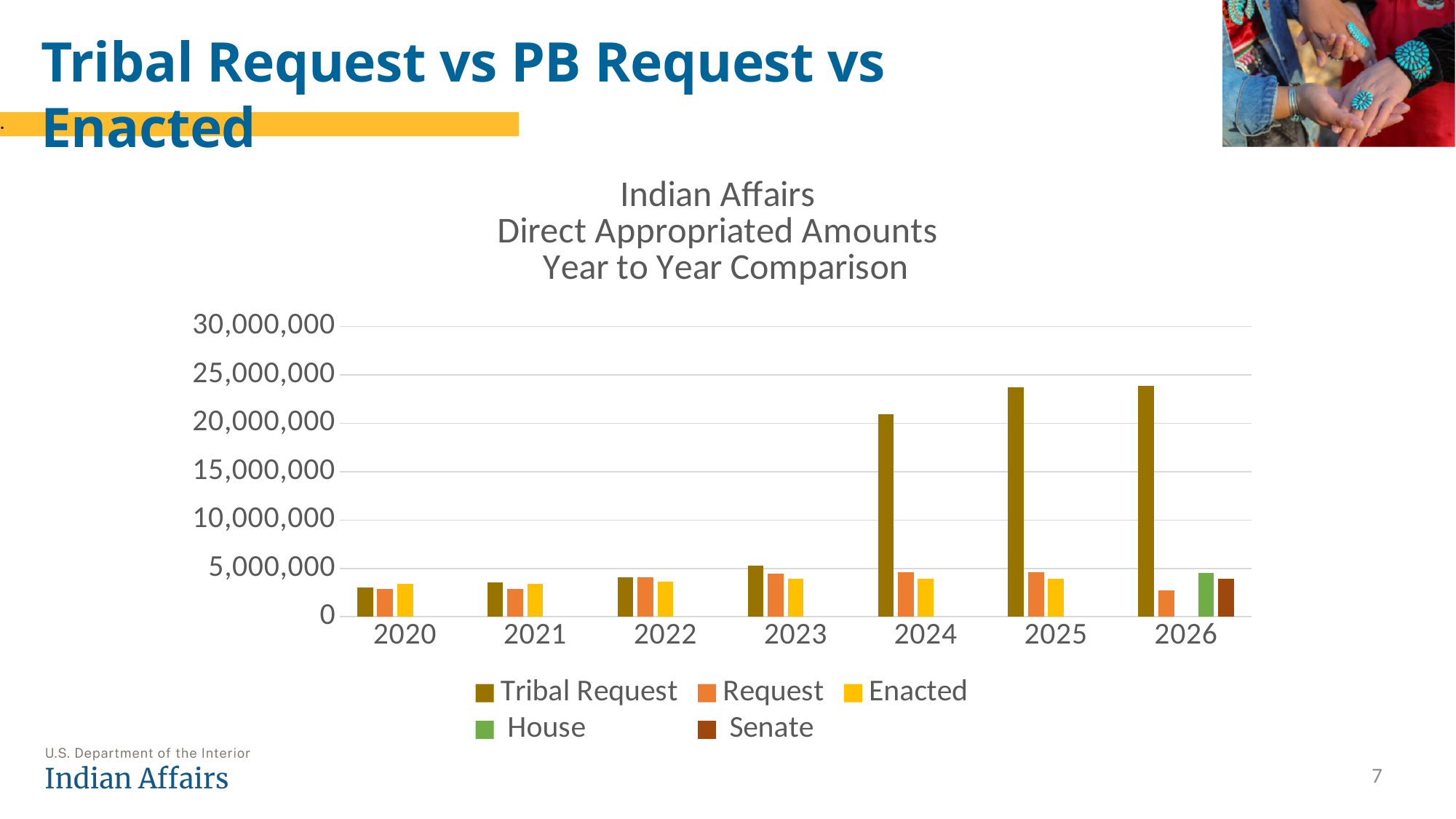
What kind of chart is shown on the slide? Bar chart In 2026, which is larger: the House value or the Senate value? House Is the Tribal Request value for 2024 greater or less than 15,000,000? greater How many series does the chart legend list? 5 Which series has the tallest bar in 2025? Tribal Request Is the Tribal Request value for 2020 greater or less than 5,000,000? less Is the Request value for 2026 greater or less than 5,000,000? less How many years are shown on the x axis of the chart? 7 Which two series appear only for the year 2026? House and Senate In 2024, which is larger: the Tribal Request or the Request? Tribal Request Does the Tribal Request series generally rise or fall from 2020 to 2026? Rise